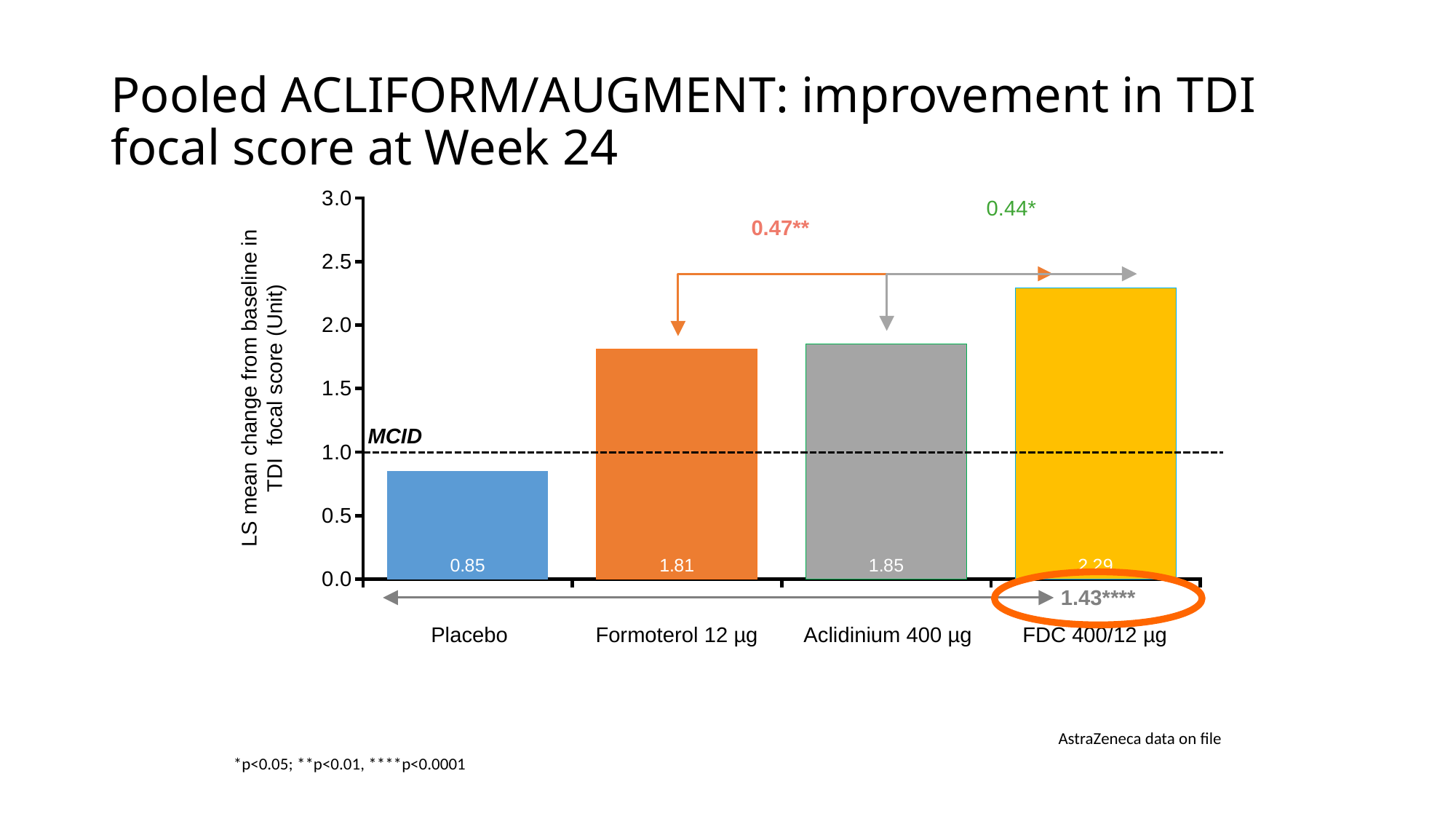
Which treatment group has the highest LS mean change from baseline in TDI focal score? FDC 400/12 µg Which treatment group has the lowest LS mean change from baseline in TDI focal score? Placebo What is the LS mean change from baseline in TDI focal score for FDC 400/12 µg? 2.29 Is the value for Placebo greater or less than 1.0? less How many treatment groups are shown on the chart? 4 What is the LS mean change from baseline in TDI focal score for Formoterol 12 µg? 1.81 Which is larger, the value for Formoterol 12 µg or the value for FDC 400/12 µg? FDC 400/12 µg What type of chart is shown on the slide? Bar chart What is the difference between the Aclidinium 400 µg value and the Formoterol 12 µg value? 0.04 What is the LS mean change from baseline in TDI focal score for Aclidinium 400 µg? 1.85 What is the LS mean change from baseline in TDI focal score for Placebo? 0.85